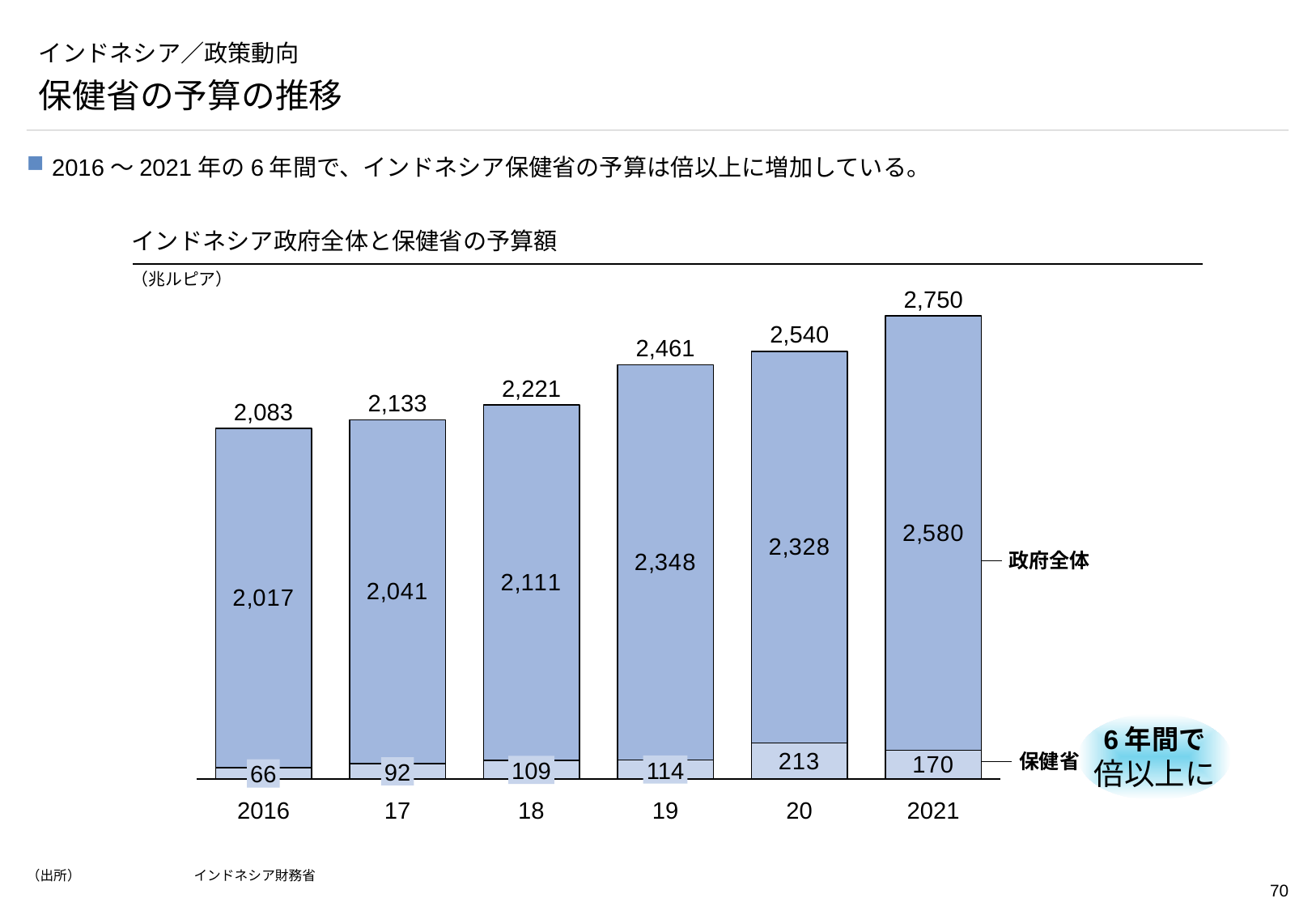
Which year has the lowest total bar? 2016 What is the 保健省 value for 2016? 66 What kind of chart is shown? Stacked bar chart What unit is given for the chart values? 兆ルピア How many series are stacked in each bar? 2 What is the 保健省 value for 20 (2020)? 213 What is the total of the stacked bar for 2019? 2,461 How many years are shown on the x axis? 6 What is the 政府全体 value for 2021? 2,580 What is the difference between the 保健省 values for 2021 and 2016? 104 Which is larger, the 政府全体 value for 19 or for 20? 19 Which year has the highest 保健省 value? 20 (2020)